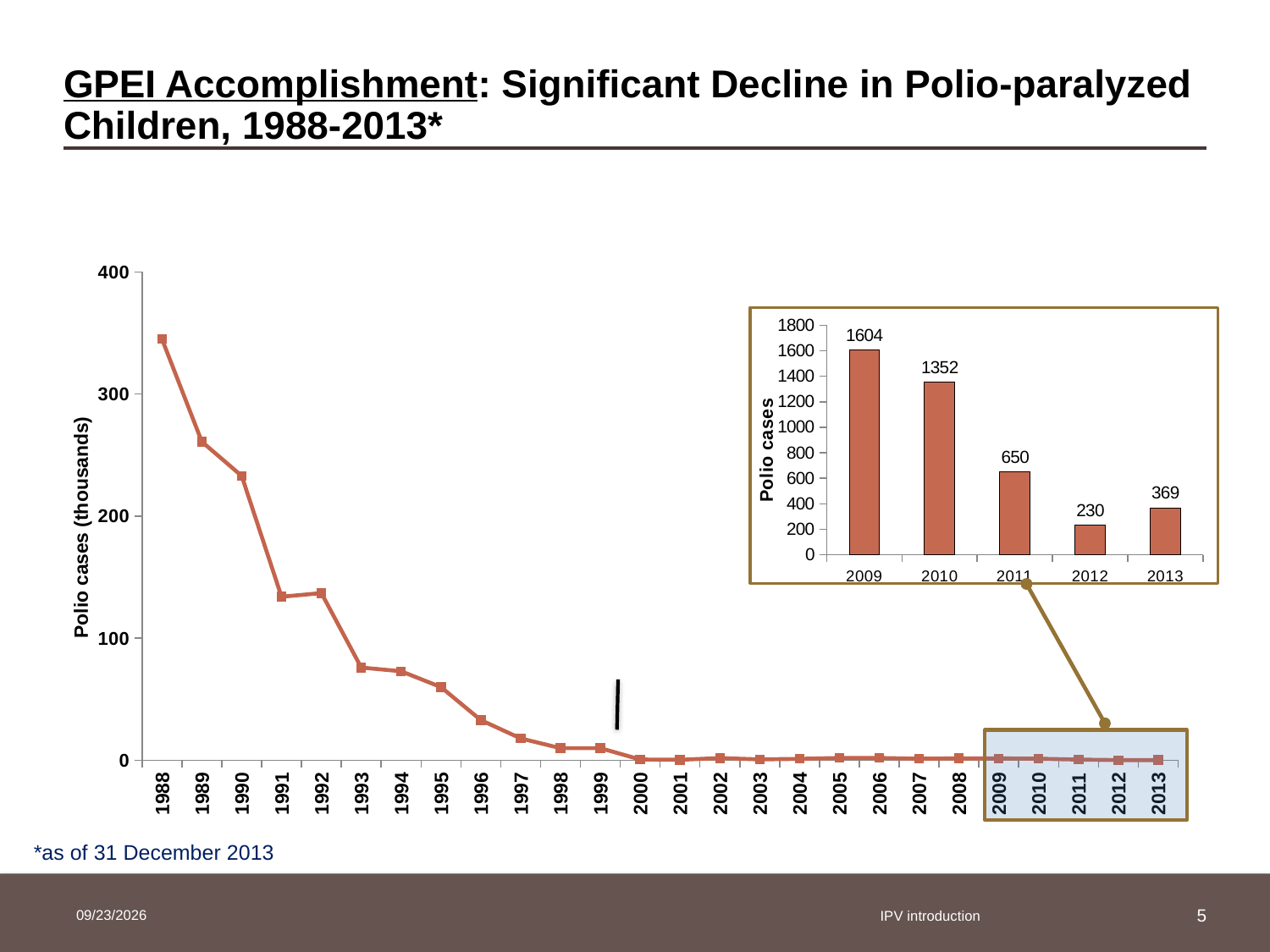
In the inset bar chart, which year has more polio cases, 2012 or 2013? 2013 In the inset bar chart, which year has the lowest number of polio cases? 2012 In the large line chart, is the value for 1993 greater or less than 100? less How many bars are shown in the inset bar chart? 5 What kind of chart is the large chart covering 1988 to 2013? Line chart In the large line chart, do polio cases generally rise or fall from 1988 to 2013? Fall In the inset bar chart, what is the number of polio cases for 2012? 230 In the inset bar chart, what is the difference in polio cases between 2009 and 2010? 252 In the inset bar chart, what is the number of polio cases for 2009? 1604 In the large line chart, is the value for 1988 greater or less than 300? greater In the inset bar chart, which year has the highest number of polio cases? 2009 What kind of chart is the inset chart showing 2009 to 2013? Bar chart